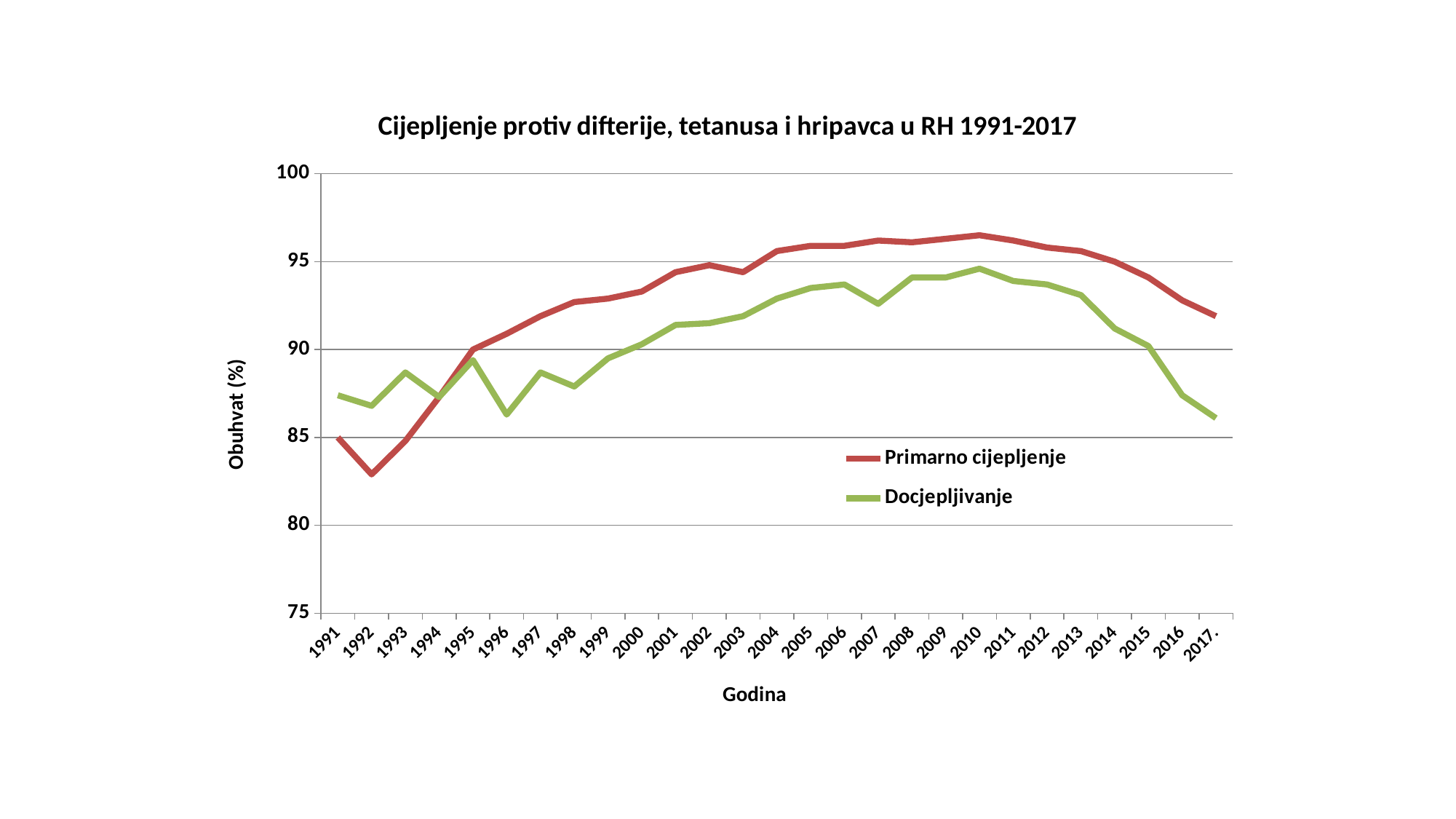
Is the value for Docjepljivanje in 1996 greater or less than 90? less How many series does the legend list? 2 Is the value for Primarno cijepljenje in 1992 greater or less than 85? less What is the label of the y axis? Obuhvat (%) What kind of chart is shown on the slide? line chart Is the value for Docjepljivanje in 2005 greater or less than 90? greater Does the value for Primarno cijepljenje rise or fall from 2010 to 2017? fall What is the title of the chart? Cijepljenje protiv difterije, tetanusa i hripavca u RH 1991-2017 In 2017, which series has the larger value, Primarno cijepljenje or Docjepljivanje? Primarno cijepljenje How many years are plotted along the x axis? 27 In which year is the value for Primarno cijepljenje lowest? 1992